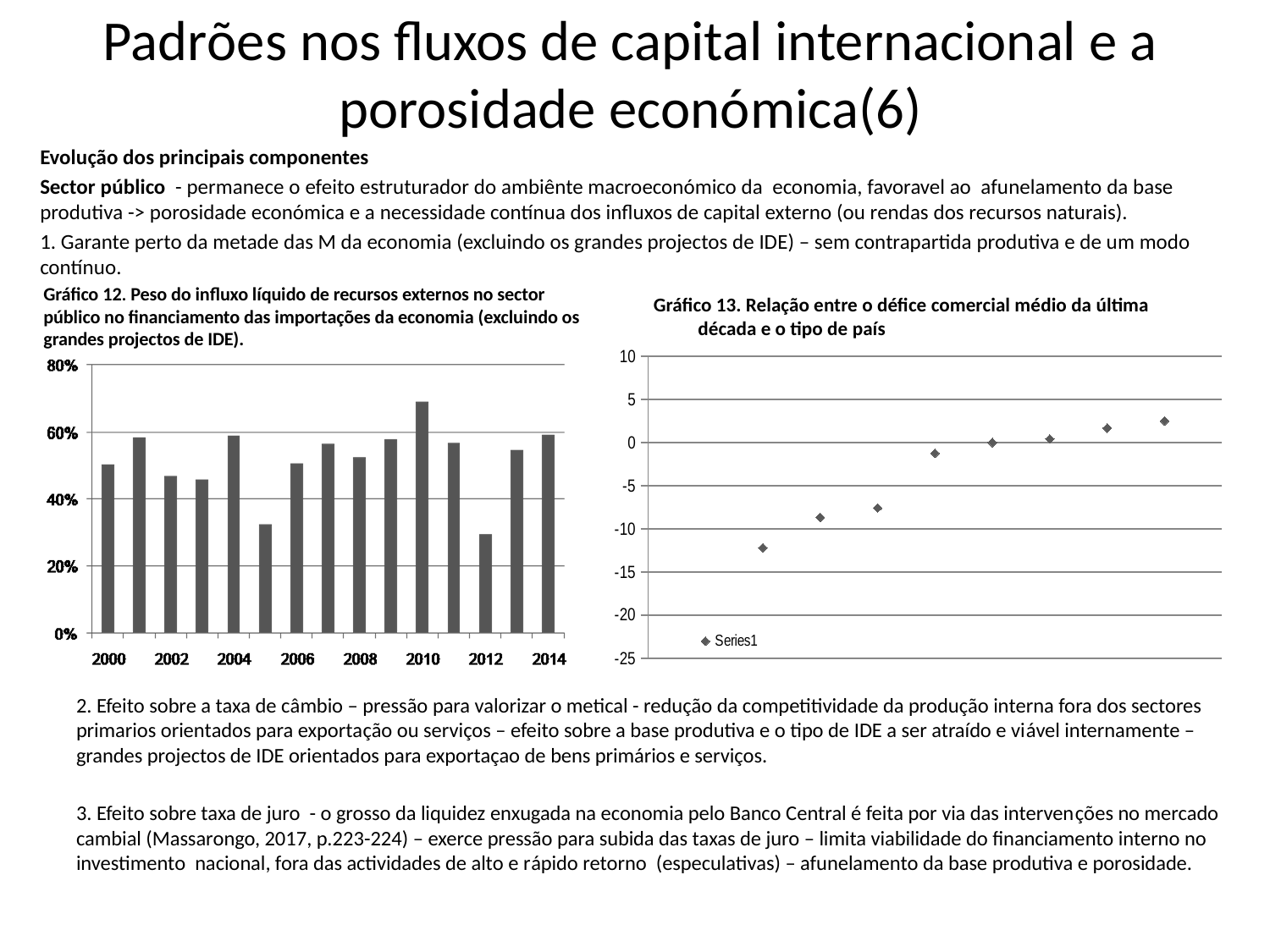
In Gráfico 13, is the leftmost point greater or less than -10? less In Gráfico 13, do the plotted values rise or fall from left to right? rise In Gráfico 12, is the value for 2000 greater or less than 40%? greater In Gráfico 12, which year has the highest value? 2010 In Gráfico 12, is the value for 2010 greater or less than 60%? greater What type of chart is Gráfico 12? bar chart In Gráfico 12, which year has the lowest value? 2012 What type of chart is Gráfico 13? scatter chart How many series does the legend of Gráfico 13 list? 1 How many bars (years) are plotted in Gráfico 12? 15 In Gráfico 12, which is larger, the value for 2004 or the value for 2005? 2004